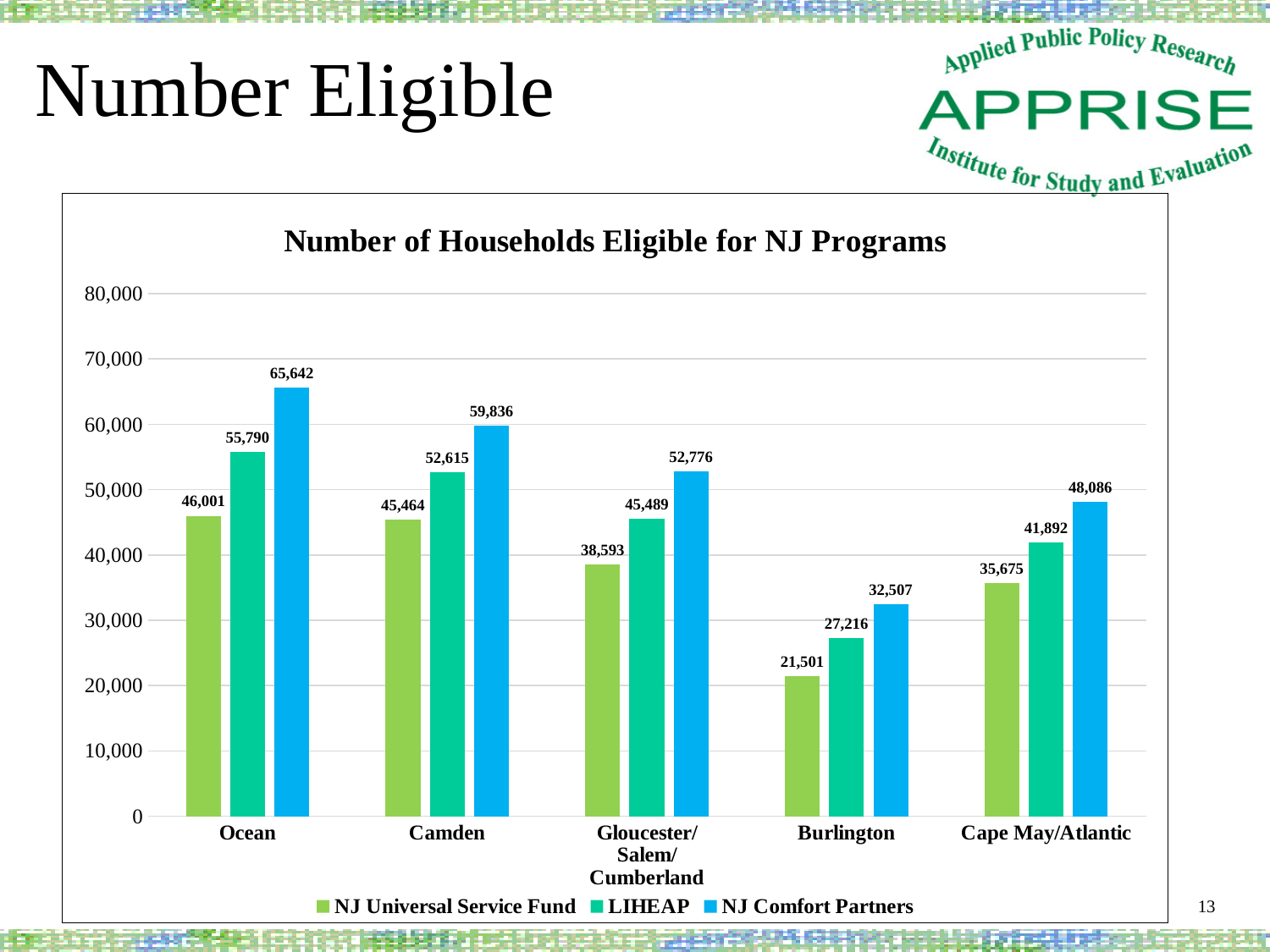
What is the difference between the NJ Comfort Partners and NJ Universal Service Fund values for Camden? 14,372 What kind of chart is shown? Bar chart What is the LIHEAP value for Burlington? 27,216 How many regions are shown on the x axis? 5 Is the NJ Comfort Partners value for Burlington greater or less than 30,000? greater Which is larger: the LIHEAP value for Gloucester/Salem/Cumberland or the NJ Universal Service Fund value for Ocean? NJ Universal Service Fund value for Ocean What is the title of the chart? Number of Households Eligible for NJ Programs Which region has the lowest number of households eligible for the NJ Universal Service Fund? Burlington How many series does the legend list? 3 What is the NJ Universal Service Fund value for Cape May/Atlantic? 35,675 Which region has the highest number of households eligible for NJ Comfort Partners? Ocean What is the number of households eligible for NJ Comfort Partners in Ocean? 65,642